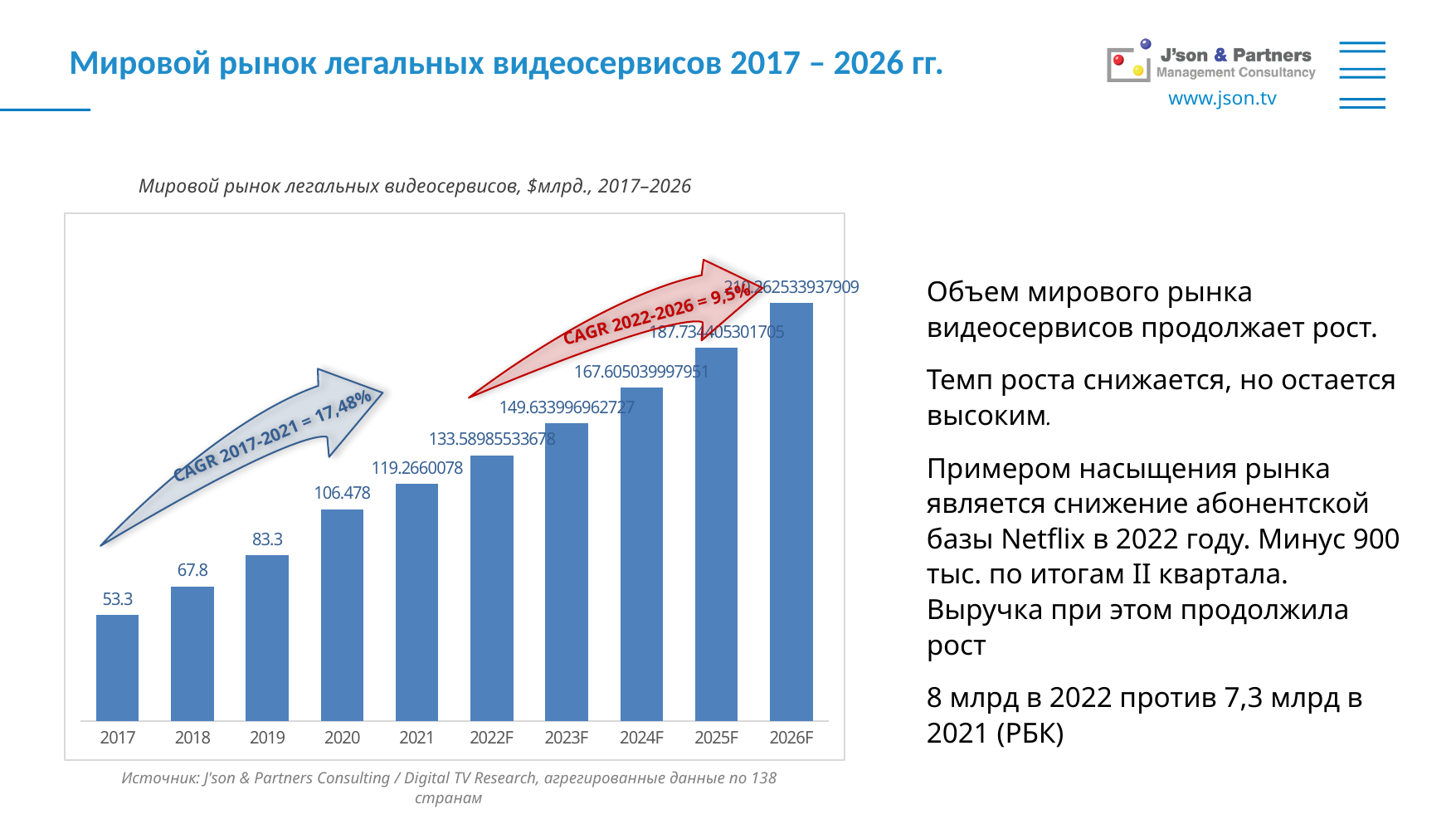
What is the value for 2017? 53.3 Do the values rise or fall from 2017 to 2026F? Rise Which year has the lowest value? 2017 What is the difference between the values for 2018 and 2017? 14.5 What is the difference between the values for 2020 and 2019? 23.178 What is the value for 2021? 119.2660078 What is the value for 2024F? 167.605039997951 What is the value for 2020? 106.478 How many bars are shown in the chart? 10 What kind of chart is shown? Bar chart Which year has the highest value? 2026F Which is larger, the value for 2023F or the value for 2021? 2023F